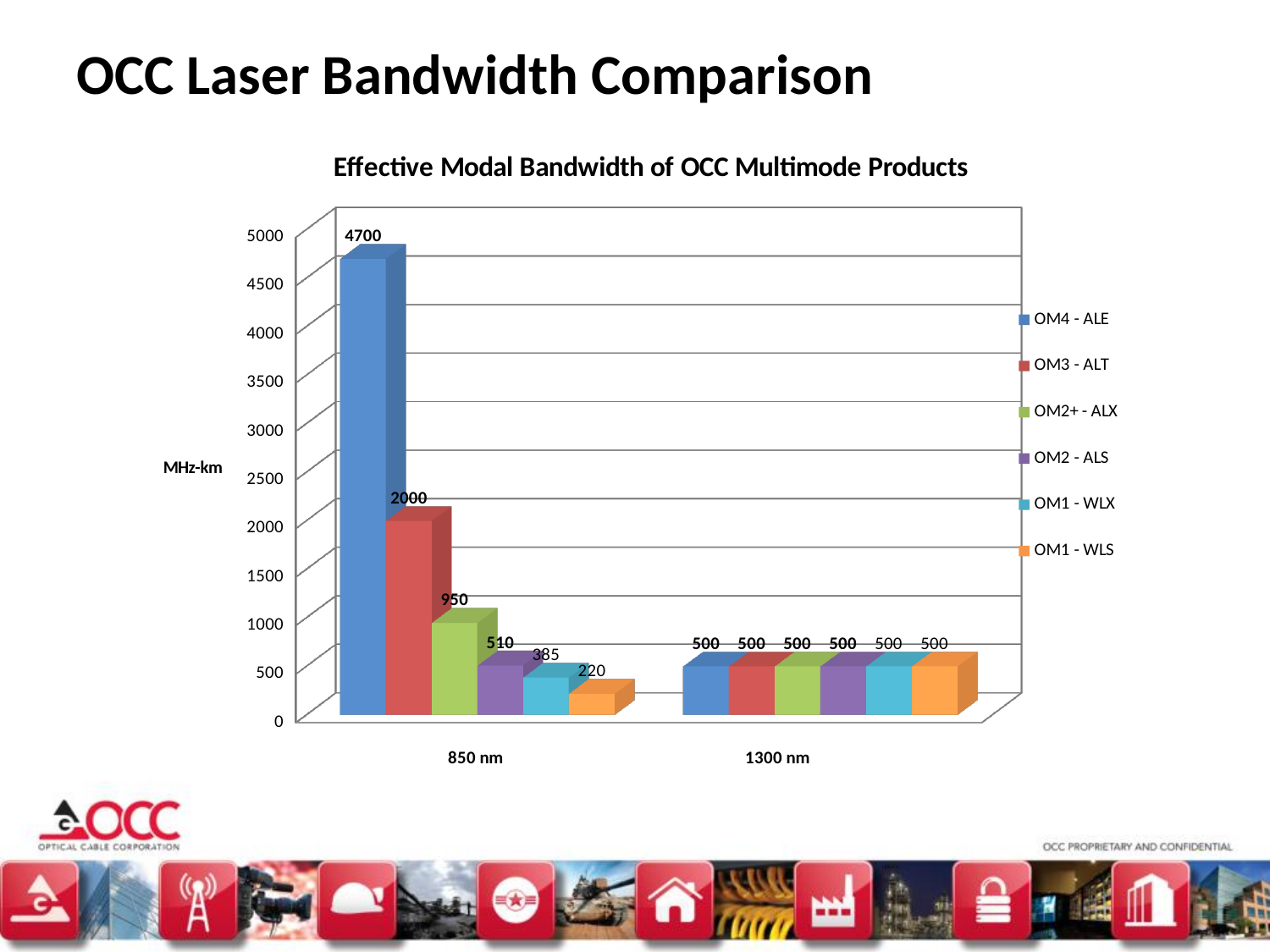
What is the title of the chart? Effective Modal Bandwidth of OCC Multimode Products What is the value for OM3 - ALT at 850 nm? 2000 How many series does the legend list? 6 Which series has the highest value at 850 nm? OM4 - ALE What is the difference between the OM4 - ALE and OM3 - ALT values at 850 nm? 2700 What is the value for OM1 - WLS at 850 nm? 220 Which series has the lowest value at 850 nm? OM1 - WLS What kind of chart is shown? Bar chart Which is larger at 850 nm: OM2+ - ALX or OM1 - WLX? OM2+ - ALX How many categories are shown on the x axis? 2 What is the value for OM2 - ALS at 1300 nm? 500 What is the value for OM4 - ALE at 850 nm? 4700